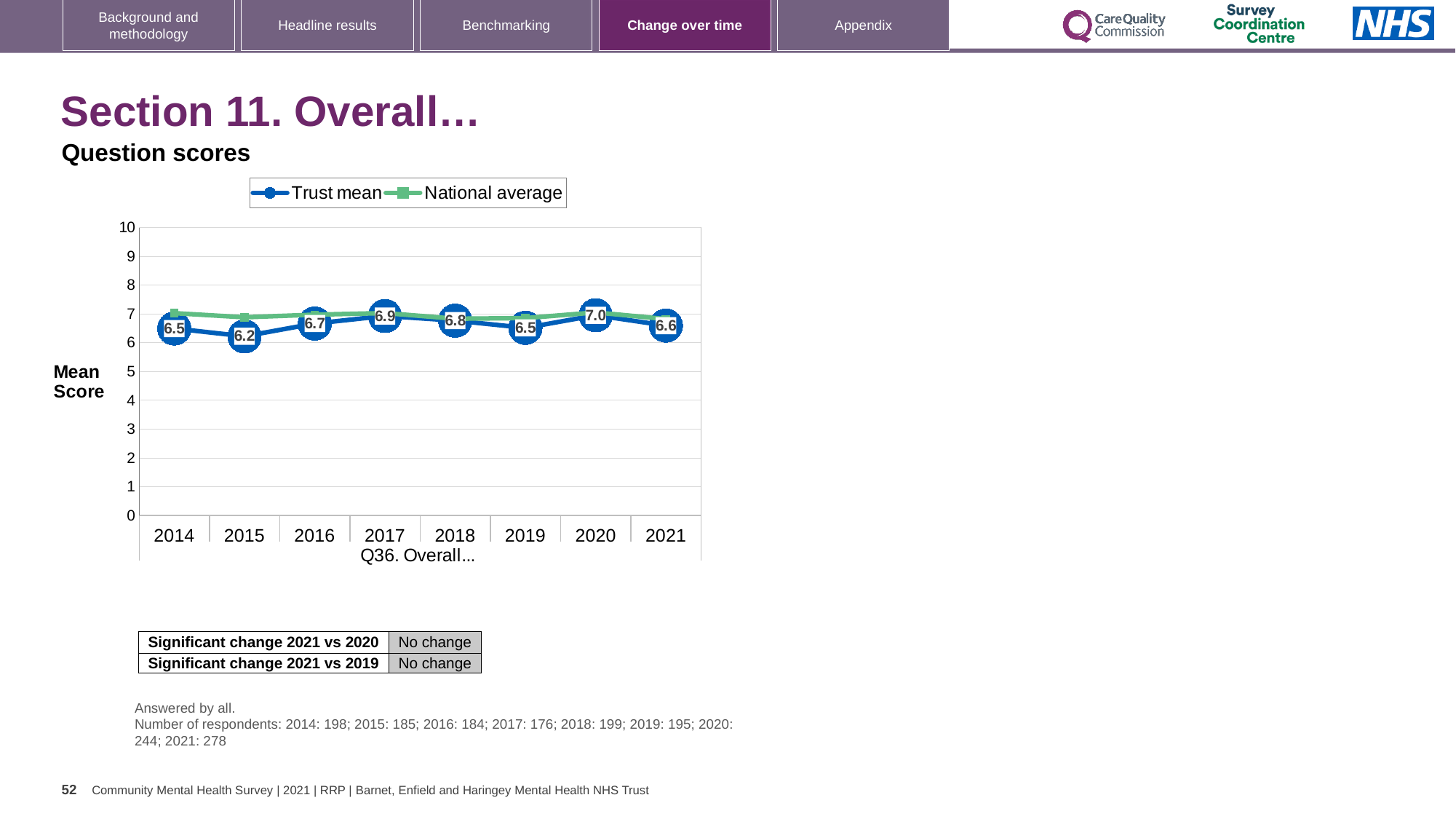
What is the Trust mean value for 2020? 7.0 In which year is the Trust mean lowest? 2015 How many years are shown on the x axis? 8 Which is larger, the Trust mean for 2016 or for 2019? 2016 In which year is the Trust mean highest? 2020 What is the Trust mean value for 2015? 6.2 Is the National average value for 2014 greater or less than 5? greater What kind of chart is shown on the slide? Line chart Does the Trust mean rise or fall from 2014 to 2015? Fall How many series does the legend list? 2 What is the difference between the Trust mean in 2020 and in 2015? 0.8 What is the Trust mean value for 2017? 6.9